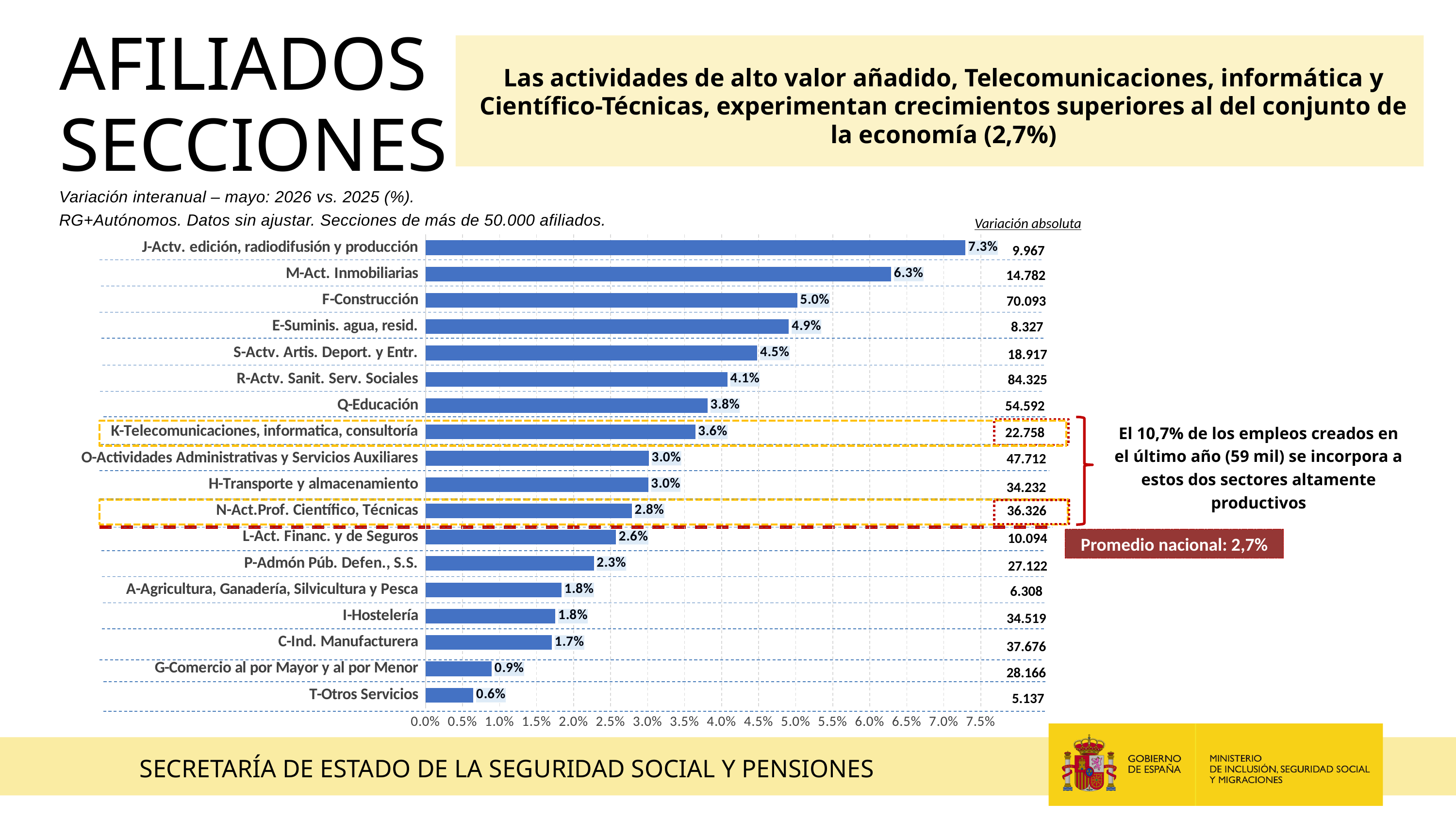
Is the interannual variation for R-Actv. Sanit. Serv. Sociales greater or less than 3.5%? greater What is the interannual variation (%) for F-Construcción? 5.0% What kind of chart is shown on the slide? bar chart Do the bar values rise or fall going from the top of the chart to the bottom? fall What is the difference in interannual variation between J-Actv. edición, radiodifusión y producción and M-Act. Inmobiliarias? 1.0% Which section has the lowest interannual variation? T-Otros Servicios Which section has the highest interannual variation? J-Actv. edición, radiodifusión y producción What is the interannual variation (%) for I-Hostelería? 1.8% What is the interannual variation (%) for K-Telecomunicaciones, informatica, consultoría? 3.6% What national average (Promedio nacional) is shown next to the chart? 2,7% How many sections (categories) are plotted in the bar chart? 18 Which has a larger interannual variation, Q-Educación or L-Act. Financ. y de Seguros? Q-Educación